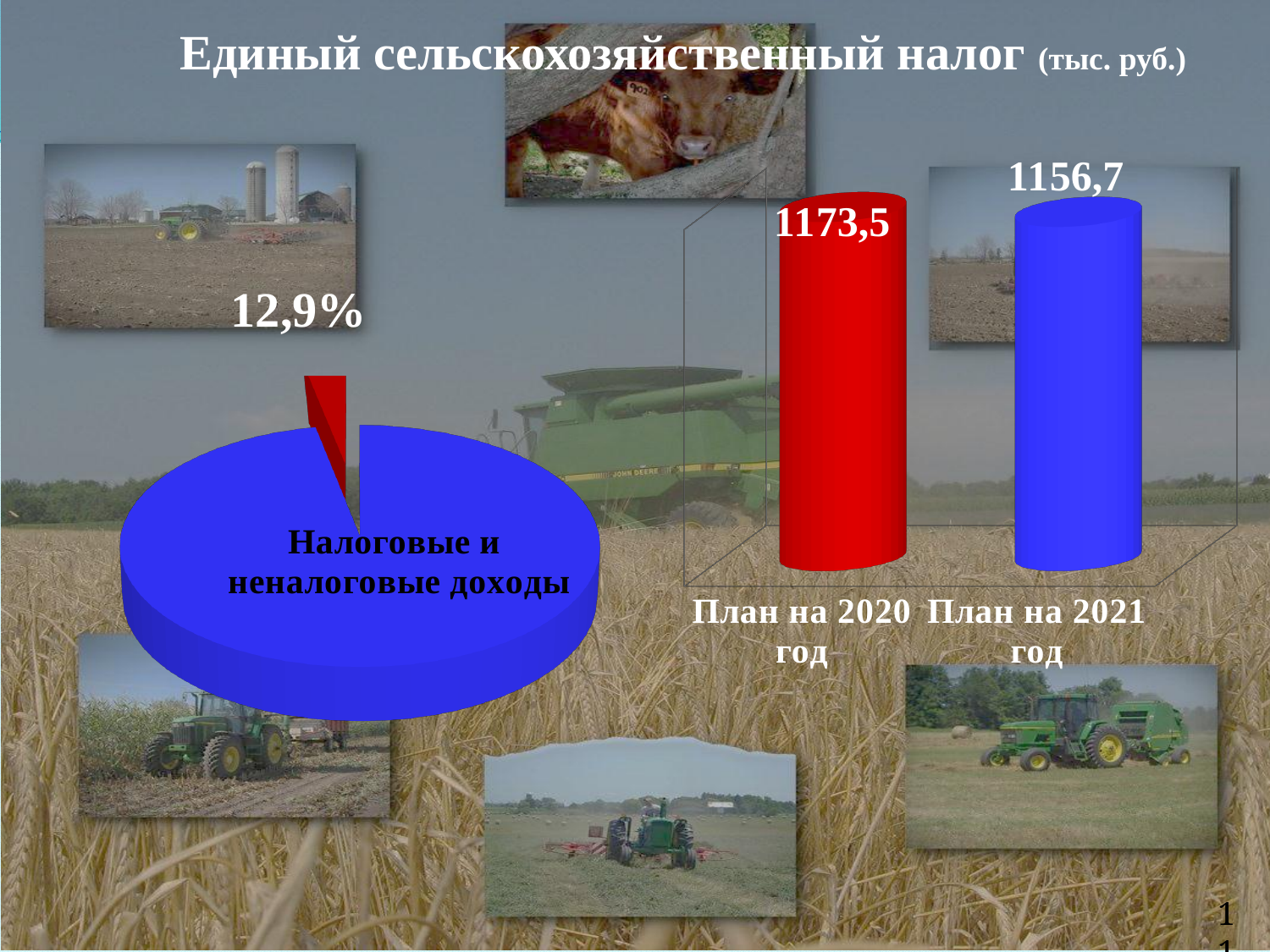
On the bar chart on the right, what is the difference between the values for План на 2020 год and План на 2021 год? 16,8 On the bar chart on the right, is the value for План на 2020 год larger or smaller than the value for План на 2021 год? larger On the bar chart on the right, which category has the higher value? План на 2020 год On the pie chart on the left, what is the label of the large blue slice? Налоговые и неналоговые доходы On the bar chart on the right, which category has the lower value? План на 2021 год On the bar chart on the right, what is the value for План на 2021 год? 1156,7 What kind of chart is shown on the left side of the slide? pie chart On the bar chart on the right, do the values rise or fall from План на 2020 год to План на 2021 год? fall On the pie chart on the left, what share is shown for the red slice? 12,9% What kind of chart is shown on the right side of the slide? bar chart On the bar chart on the right, how many bars are plotted? 2 On the bar chart on the right, what is the value for План на 2020 год? 1173,5